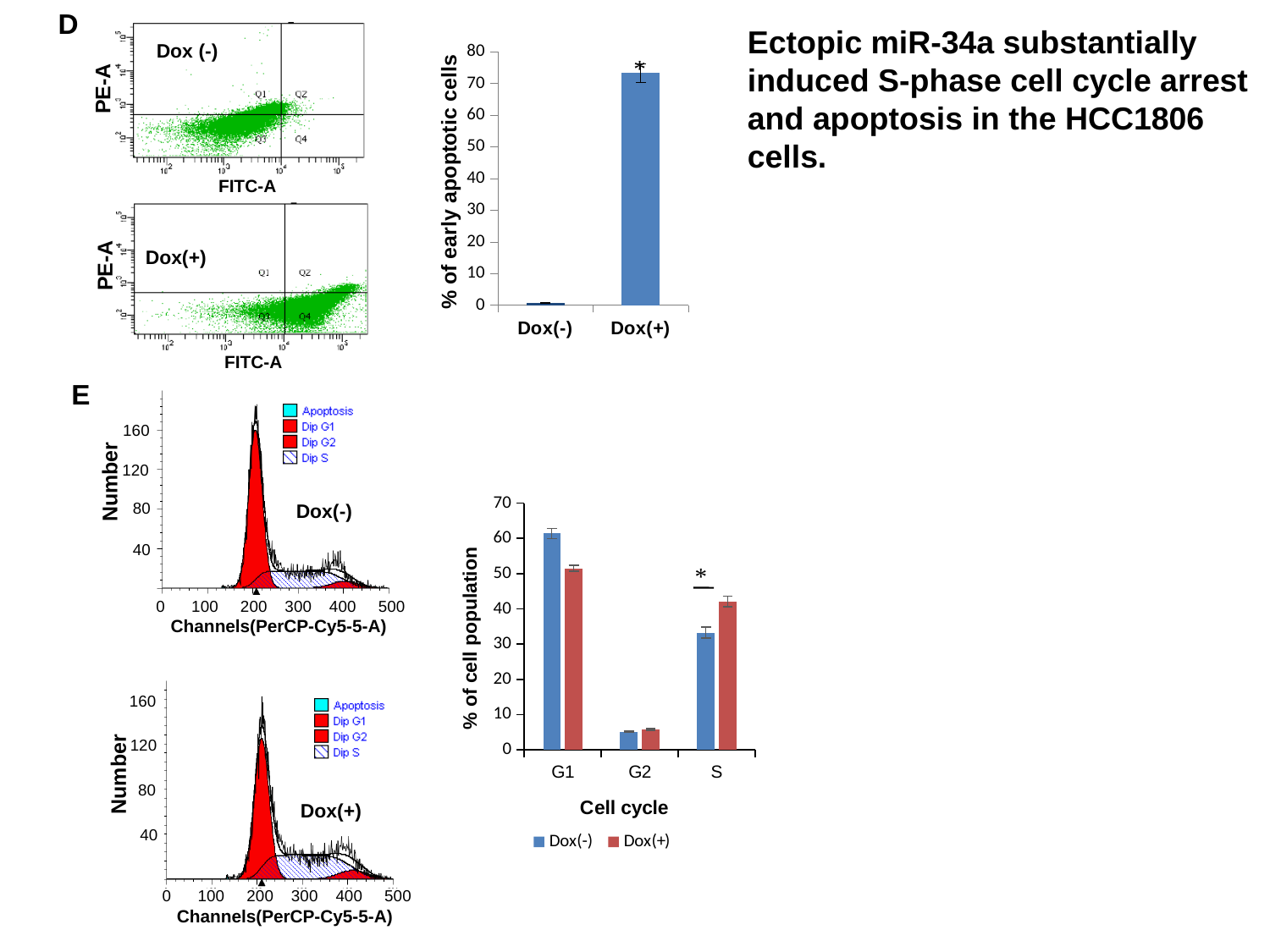
In the '% of cell population' chart, which series has the larger value for S? Dox(+) In the '% of cell population' chart, is the Dox(-) value for G1 greater or less than 50? greater What is the x-axis title of the '% of cell population' chart? Cell cycle In the '% of cell population' chart, which series has the larger value for G1? Dox(-) How many series does the legend of the '% of cell population' chart list? 2 What kind of chart is the '% of early apoptotic cells' chart? bar chart How many categories are shown on the x axis of the '% of early apoptotic cells' chart? 2 In the '% of early apoptotic cells' chart, is the value for Dox(+) greater or less than 70? greater In the '% of cell population' chart, is the Dox(+) value for S greater or less than 40? greater In the '% of early apoptotic cells' chart, which category has the higher value? Dox(+) In the '% of cell population' chart, which cell cycle phase has the lowest values for both series? G2